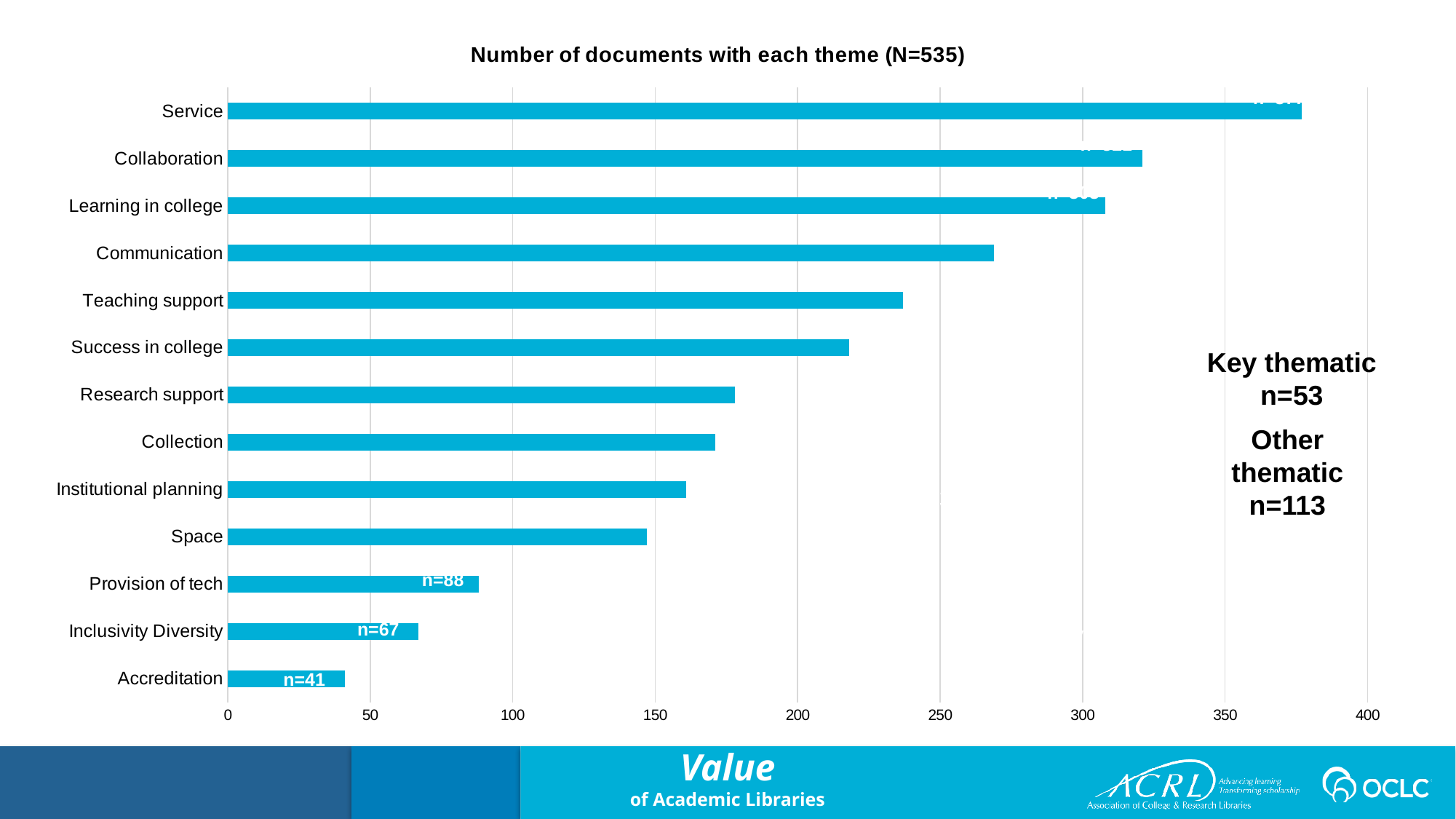
What is the difference between the values for Provision of tech and Accreditation? 47 Is the value for Service greater or less than 350? greater Which theme has the highest number of documents? Service What is the value shown for Provision of tech? n=88 What type of chart is shown on the slide? bar chart Is the value for Teaching support greater or less than 250? less How many themes (categories) are plotted in the chart? 13 What is the title of the chart? Number of documents with each theme (N=535) Which has more documents, Communication or Teaching support? Communication Which theme has the lowest number of documents? Accreditation What is the value shown for Accreditation? n=41 What is the value shown for Inclusivity Diversity? n=67